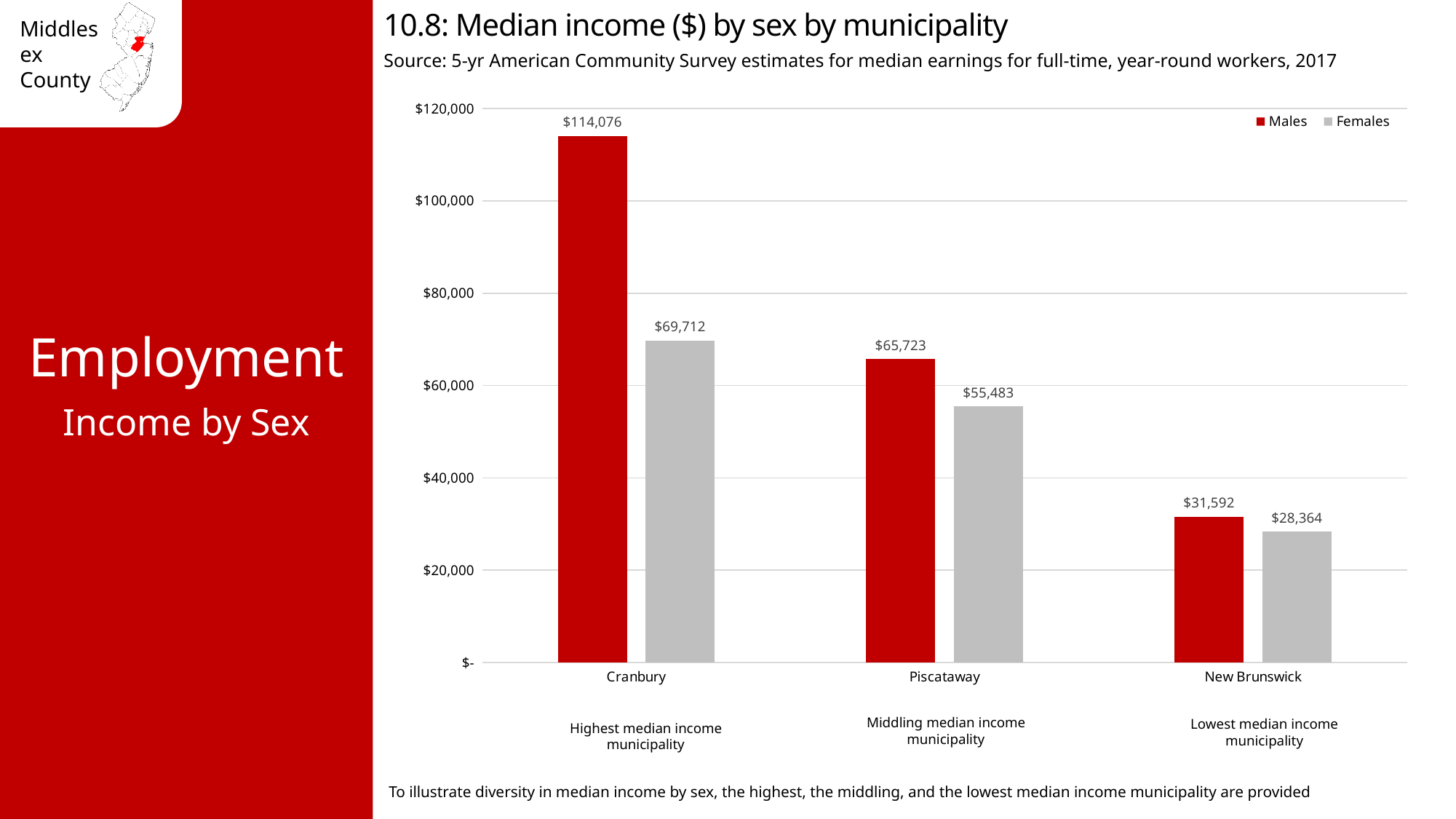
What is the median income for Females in Cranbury? $69,712 What kind of chart is shown on the slide? Bar chart What is the difference between the Males and Females median income in New Brunswick? $3,228 What is the median income for Males in Cranbury? $114,076 Which is larger: the Females median income in Cranbury or the Males median income in Piscataway? Females median income in Cranbury What is the difference between the Males and Females median income in Cranbury? $44,364 How many series does the legend list? 2 Which municipality has the highest median income for Males? Cranbury What is the median income for Females in Piscataway? $55,483 Which municipality has the lowest median income for Females? New Brunswick What is the median income for Males in New Brunswick? $31,592 How many municipalities are shown on the chart? 3